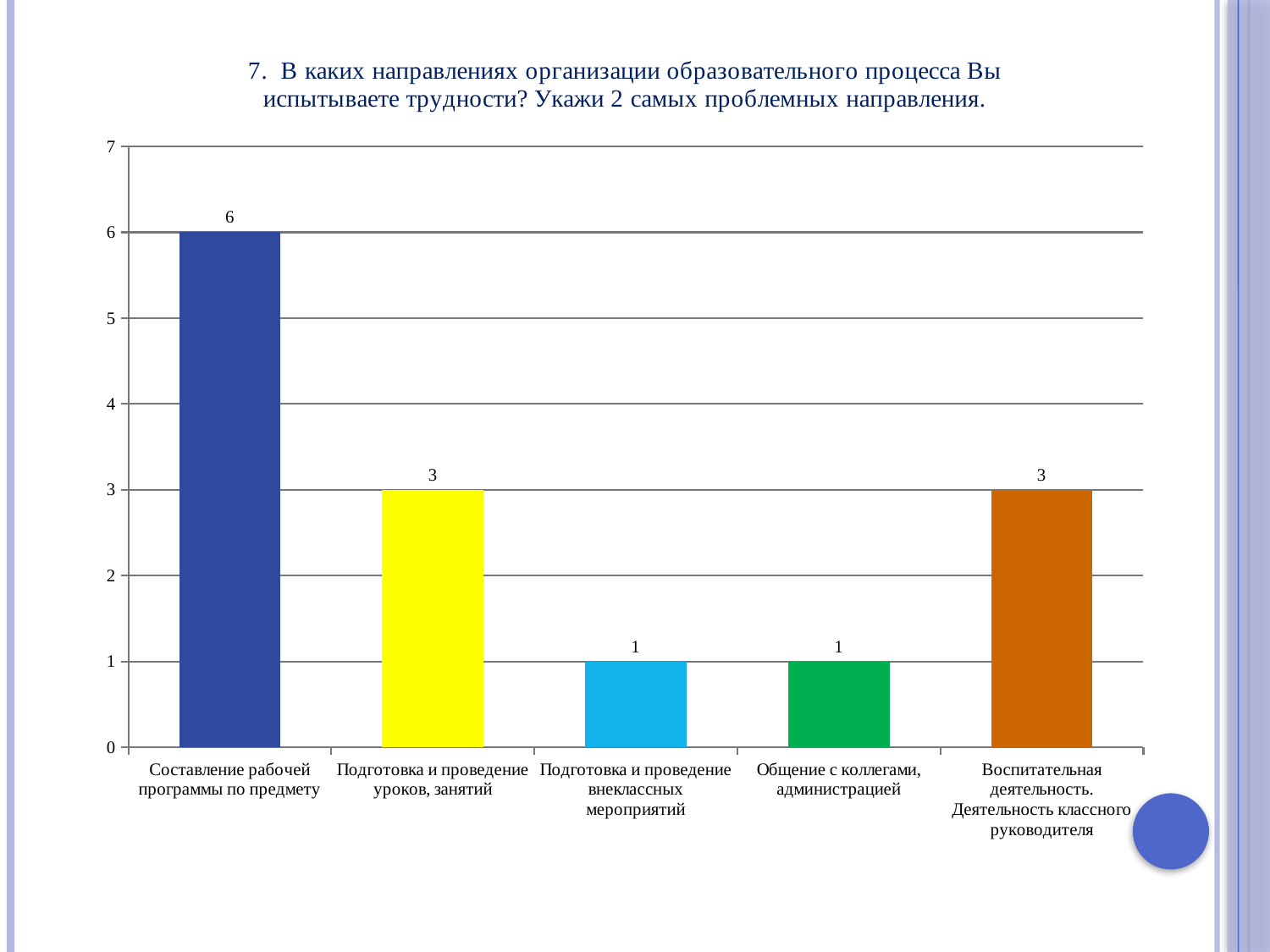
What is the highest value shown on the vertical axis? 7 Which category has the highest value? Составление рабочей программы по предмету Which is larger: the value for "Подготовка и проведение внеклассных мероприятий" or the value for "Воспитательная деятельность. Деятельность классного руководителя"? Воспитательная деятельность. Деятельность классного руководителя How many categories are shown on the x axis? 5 Is the value for "Составление рабочей программы по предмету" greater or less than 5? greater What is the difference between the values for "Составление рабочей программы по предмету" and "Подготовка и проведение уроков, занятий"? 3 What colour is the bar for "Подготовка и проведение уроков, занятий"? yellow What is the value for "Подготовка и проведение уроков, занятий"? 3 What is the value for "Воспитательная деятельность. Деятельность классного руководителя"? 3 What kind of chart is shown on the slide? bar chart What is the value for "Составление рабочей программы по предмету"? 6 What is the value for "Общение с коллегами, администрацией"? 1